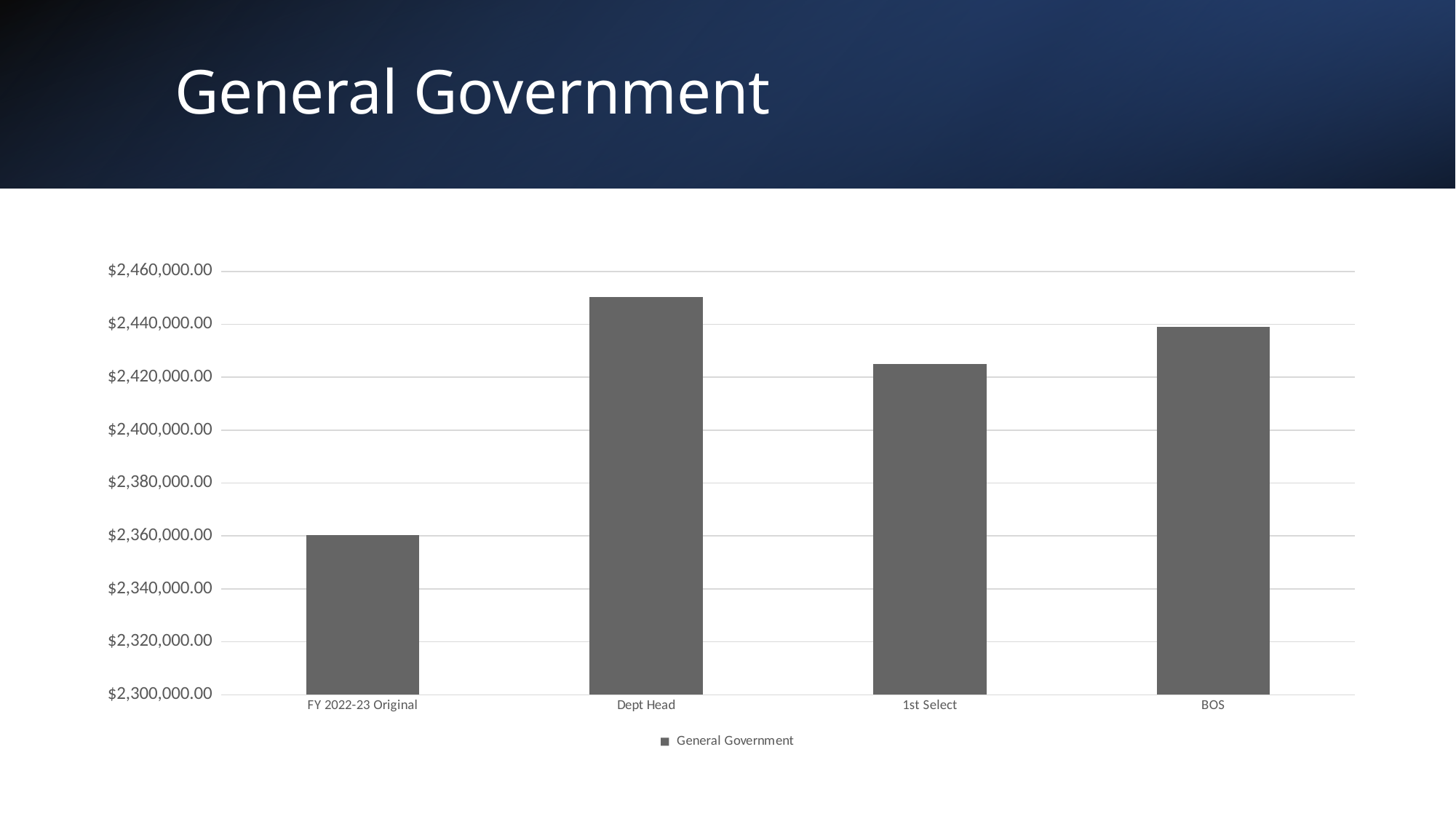
What kind of chart is shown on the slide? Bar chart Which category has the highest value in the chart? Dept Head Which is larger, the value for BOS or the value for 1st Select? BOS What is the name of the series shown in the legend? General Government Is the value for BOS greater or less than $2,420,000.00? greater How many categories are shown on the x axis of the chart? 4 Is the value for 1st Select greater or less than $2,440,000.00? less Which category has the lowest value in the chart? FY 2022-23 Original Does the value rise or fall from FY 2022-23 Original to Dept Head? rise Is the value for Dept Head greater or less than $2,440,000.00? greater How many series does the chart's legend list? 1